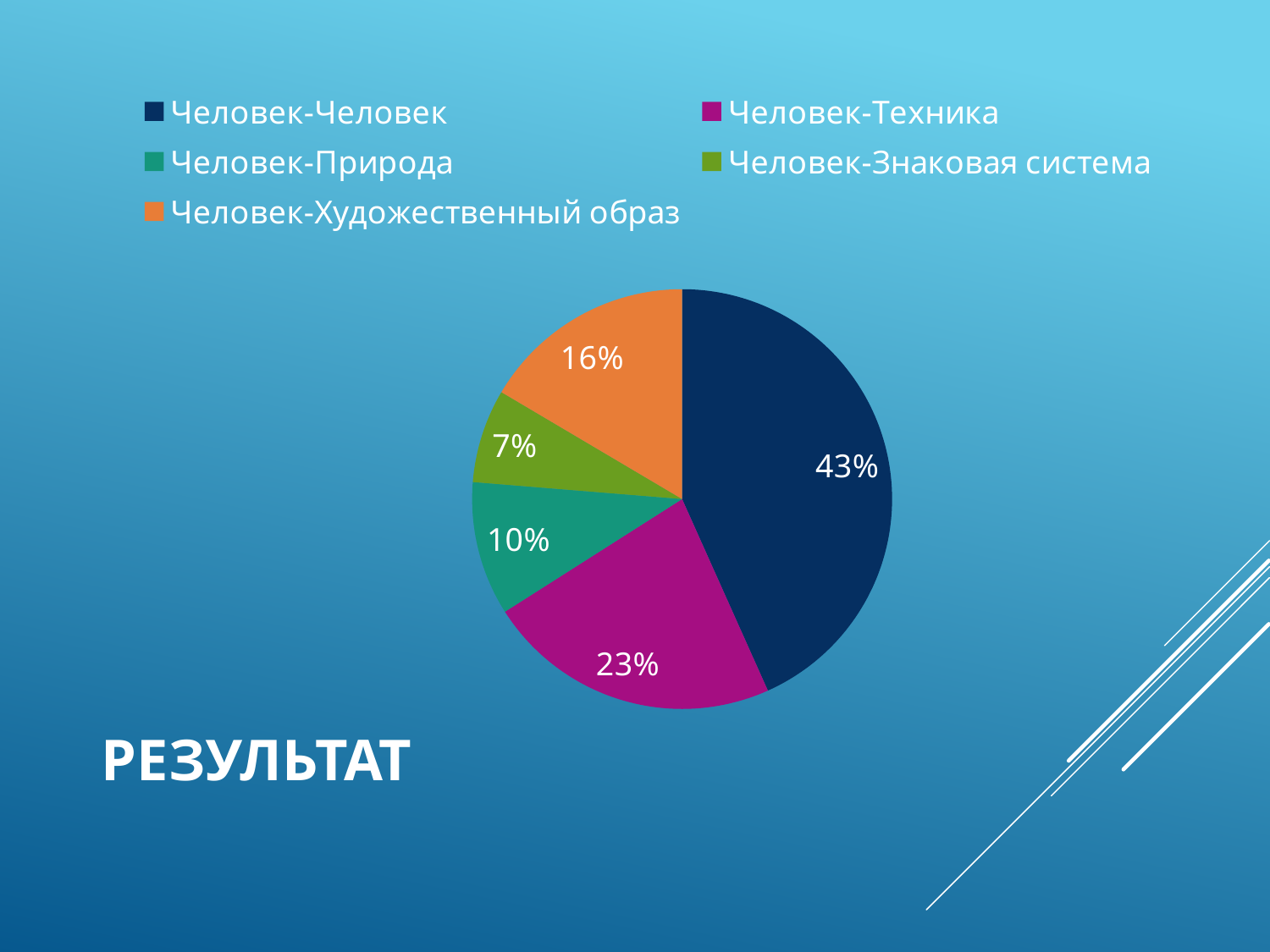
Which category has the largest slice? Человек-Человек How many categories does the legend list? 5 What is the value for Человек-Природа? 10% What share of the pie does Человек-Человек have? 43% Which category has the smallest slice? Человек-Знаковая система What is the value for Человек-Художественный образ? 16% What is the value for Человек-Техника? 23% What colour is the slice for Человек-Техника? magenta Which is larger, Человек-Художественный образ or Человек-Природа? Человек-Художественный образ What kind of chart is shown on the slide? pie chart What is the value for Человек-Знаковая система? 7% What is the difference between Человек-Человек and Человек-Техника? 20%